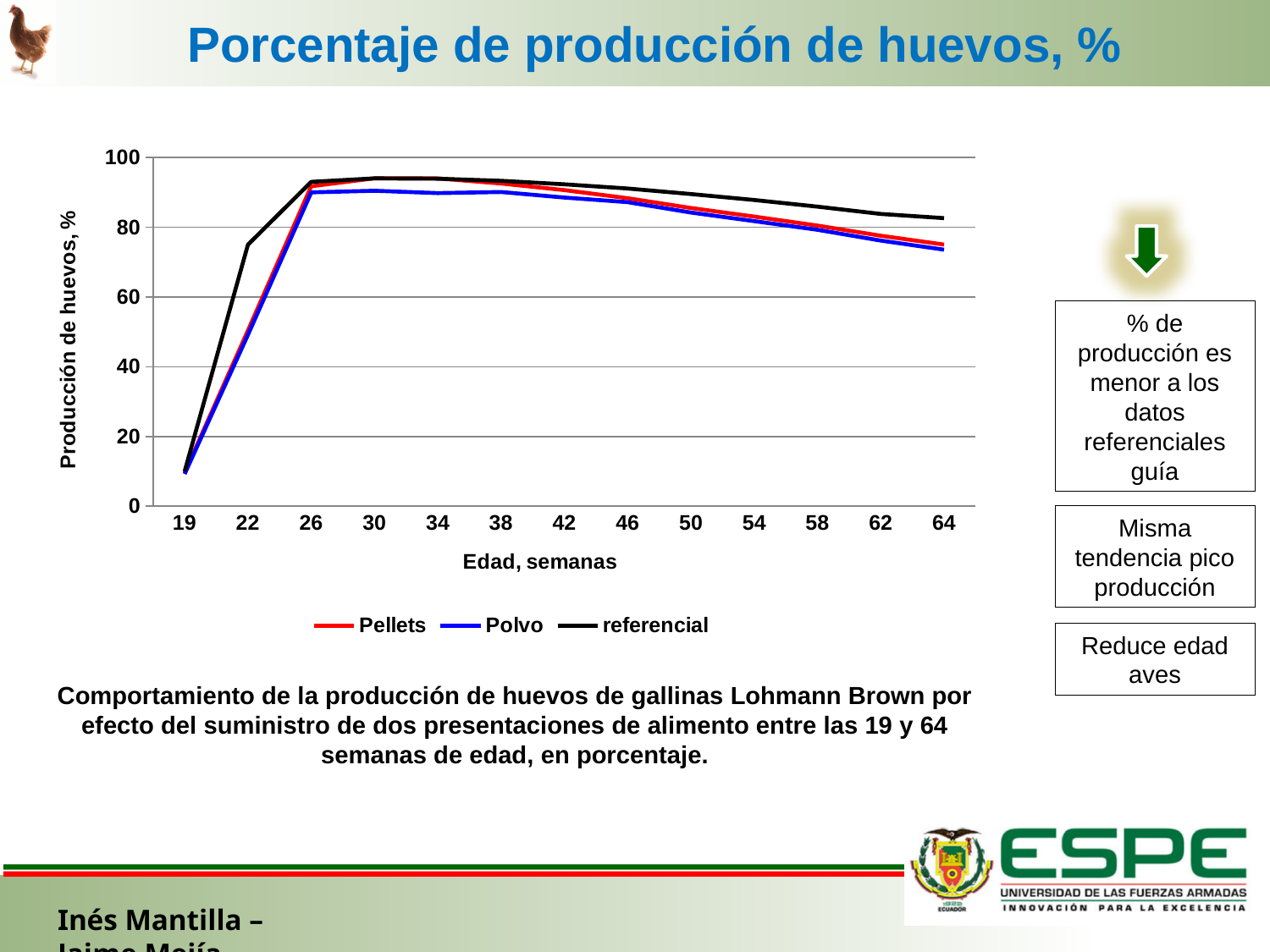
Is the value for Polvo at week 19 greater or less than 20? less Is the value for Polvo at week 64 greater or less than 80? less At week 22, which is larger: referencial or Pellets? referencial Do the referencial values rise or fall from week 34 to week 64? fall Is the value for referencial at week 22 greater or less than 60? greater How many series does the legend list? 3 Which series is drawn in black? referencial At week 64, which is larger: referencial or Polvo? referencial What kind of chart is shown on the slide? line chart What is the title of the x axis? Edad, semanas How many age points (weeks) are shown on the x axis? 13